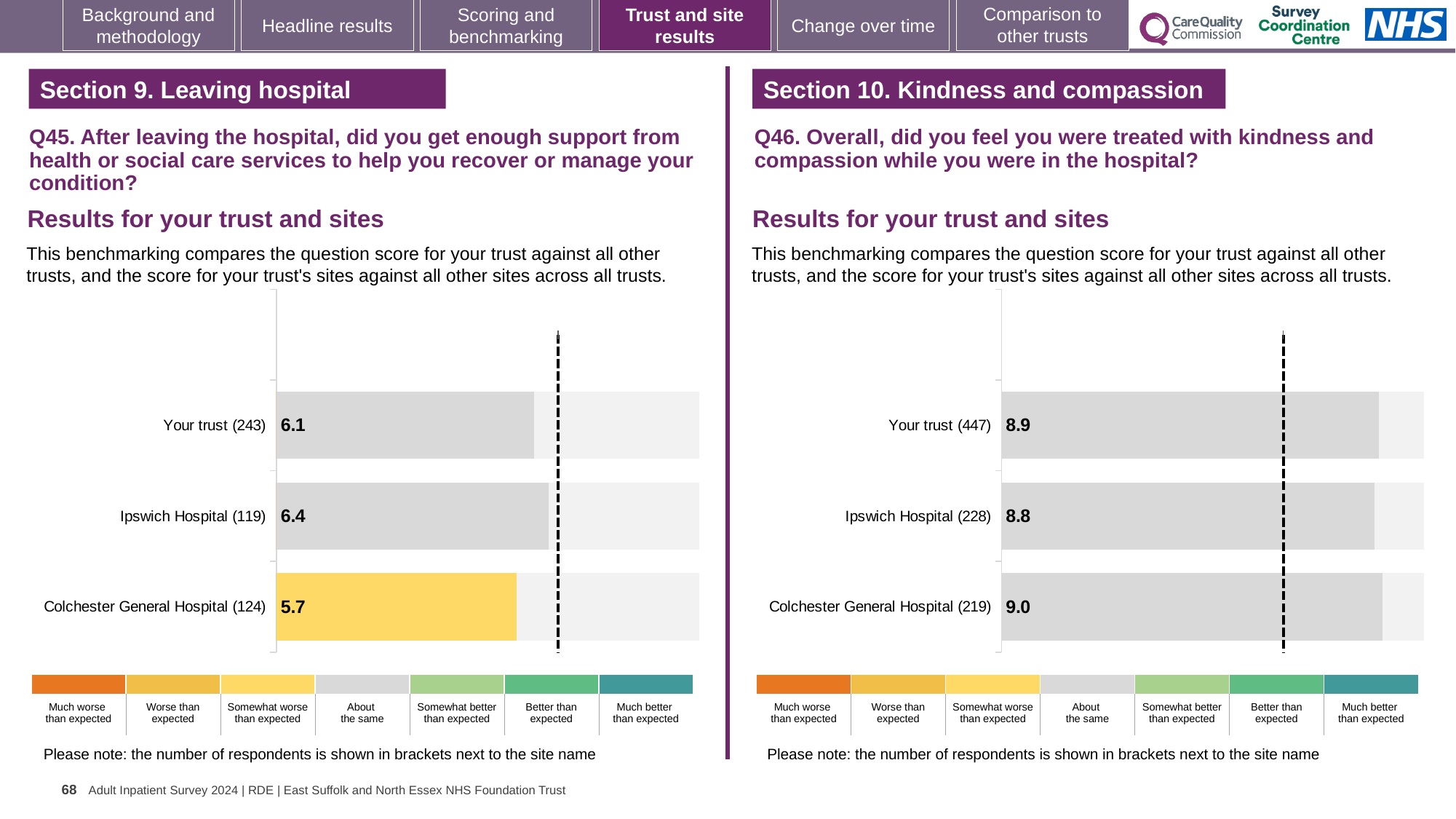
In the Q45 chart (left), what is the difference between the scores for Ipswich Hospital and Colchester General Hospital? 0.7 In the Q46 chart (right), is the score for Your trust larger or smaller than the score for Ipswich Hospital? larger How many bars are plotted in the Q46 chart (right)? 3 In the Q45 chart (left), which site or trust has the highest score? Ipswich Hospital In the Q45 chart (left), how many respondents are shown for Ipswich Hospital? 119 What type of chart is used for the Q45 results (left)? Bar chart In the Q46 chart (right), which site or trust has the highest score? Colchester General Hospital In the Q45 chart (left), which site or trust has the lowest score? Colchester General Hospital In the Q45 chart (left), what is the score for Colchester General Hospital? 5.7 In the Q46 chart (right), what is the difference between the scores for Colchester General Hospital and Your trust? 0.1 In the Q46 chart (right), what is the score for Ipswich Hospital? 8.8 In the Q45 chart (left), what is the score for Your trust? 6.1